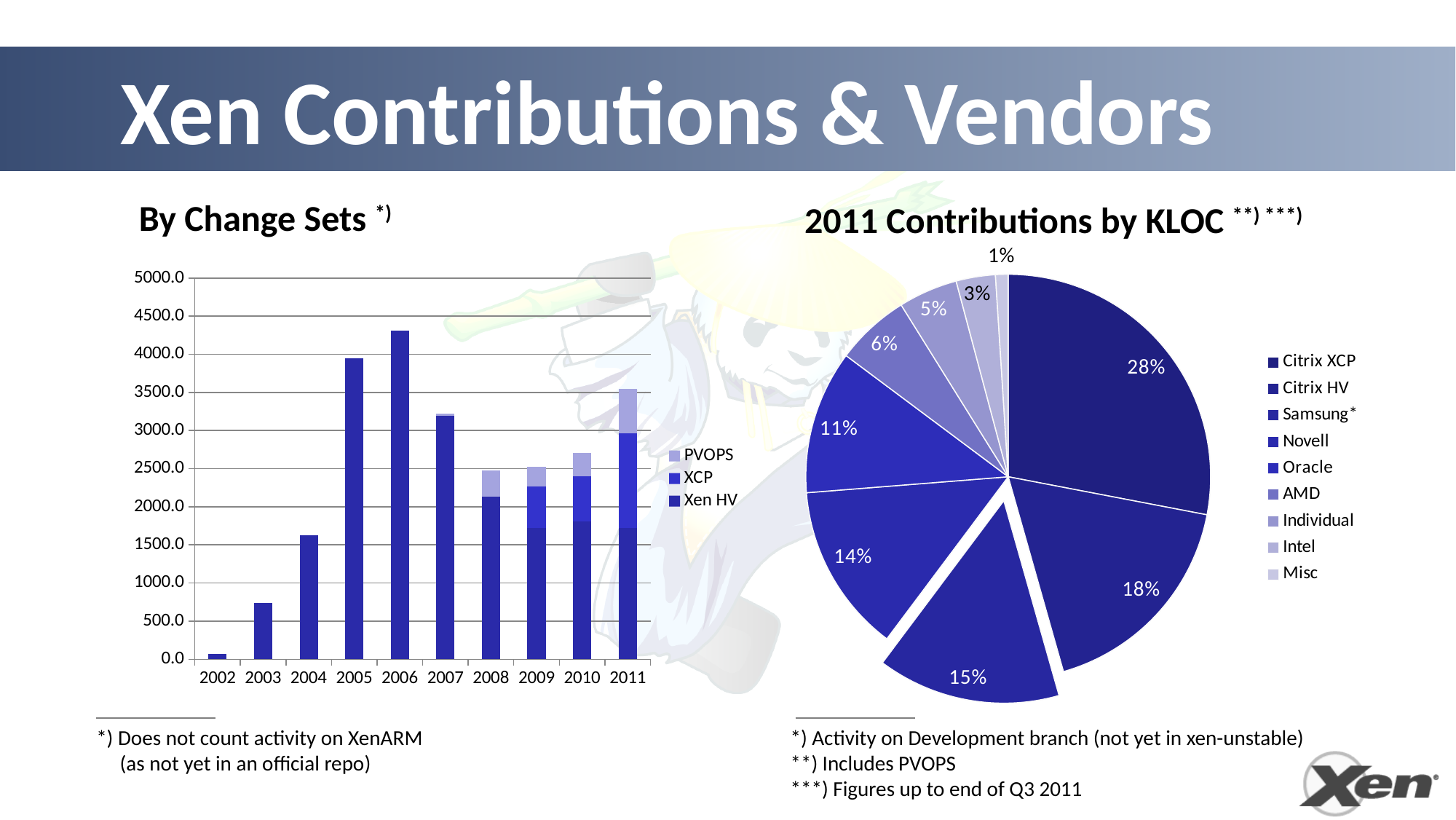
In the 'By Change Sets' chart, which year has the tallest bar? 2006 In the 'By Change Sets' chart, is the total for 2003 greater or less than 1000.0? less What kind of chart is the 'By Change Sets' chart on the left? Bar chart In the 'By Change Sets' chart, do the bar totals rise or fall from 2002 to 2006? Rise In the 'By Change Sets' chart, which year has the shortest bar? 2002 In the 'By Change Sets' chart, how many years are shown on the x axis? 10 In the 'By Change Sets' chart, is the total for 2006 greater or less than 4000.0? greater What kind of chart is the '2011 Contributions by KLOC' chart on the right? Pie chart In the '2011 Contributions by KLOC' pie chart, what share does Citrix XCP have? 28% How many entries does the legend of the '2011 Contributions by KLOC' pie chart list? 9 How many series does the legend of the 'By Change Sets' chart list? 3 In the '2011 Contributions by KLOC' pie chart, what is the difference between the Citrix XCP share and the Citrix HV share? 10 percentage points